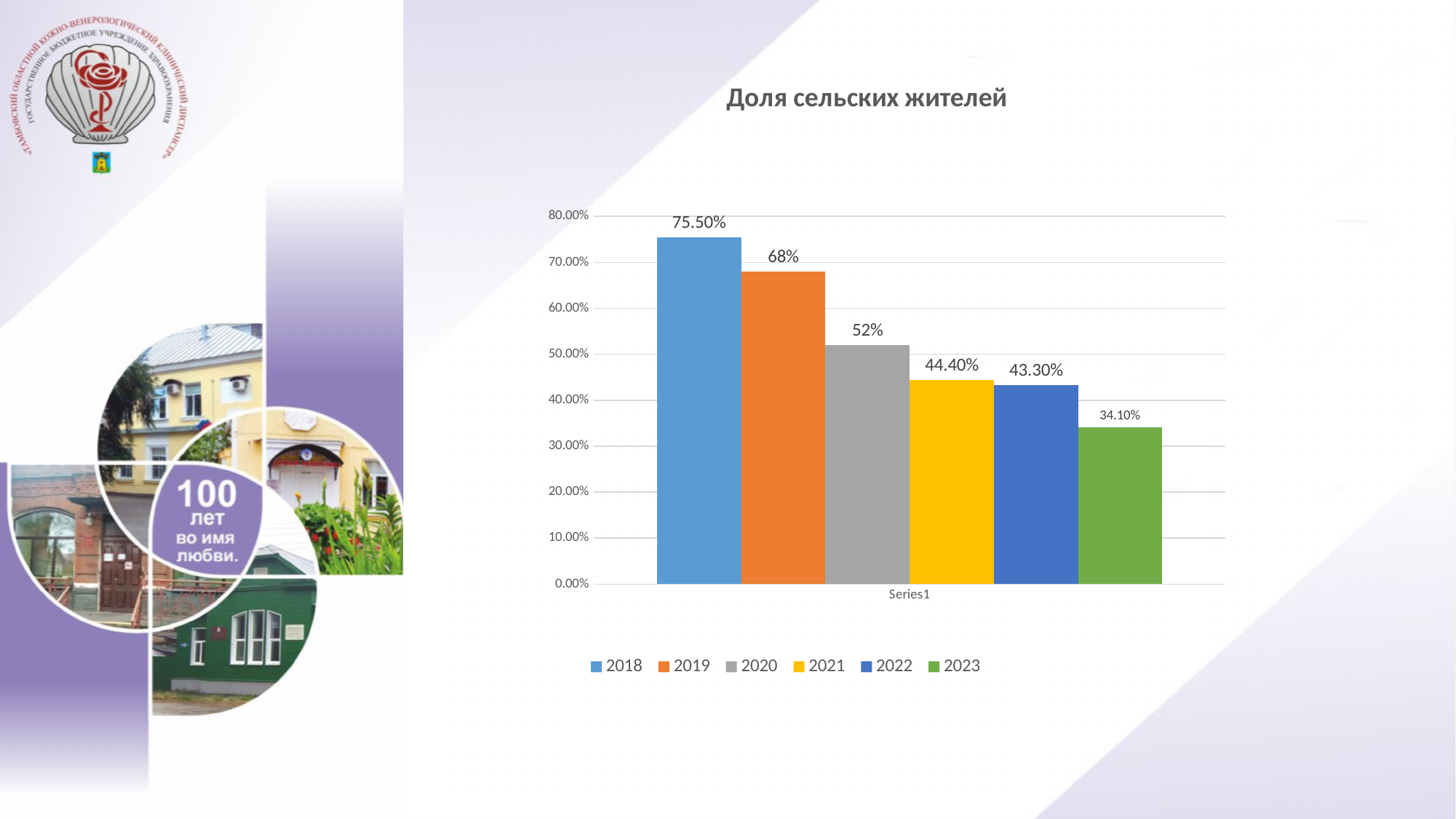
How many series does the legend list? 6 Is the value for 2022 greater or less than 40.00%? greater What is the difference between the values for 2020 and 2023? 17.90% What kind of chart is shown? bar chart Which year has the lowest value? 2023 Which year has the highest value? 2018 What is the value for 2023? 34.10% Which is larger, the value for 2019 or the value for 2020? 2019 What is the value for 2021? 44.40% What is the difference between the values for 2018 and 2019? 7.50% What is the title of the chart? Доля сельских жителей What is the value for 2018? 75.50%